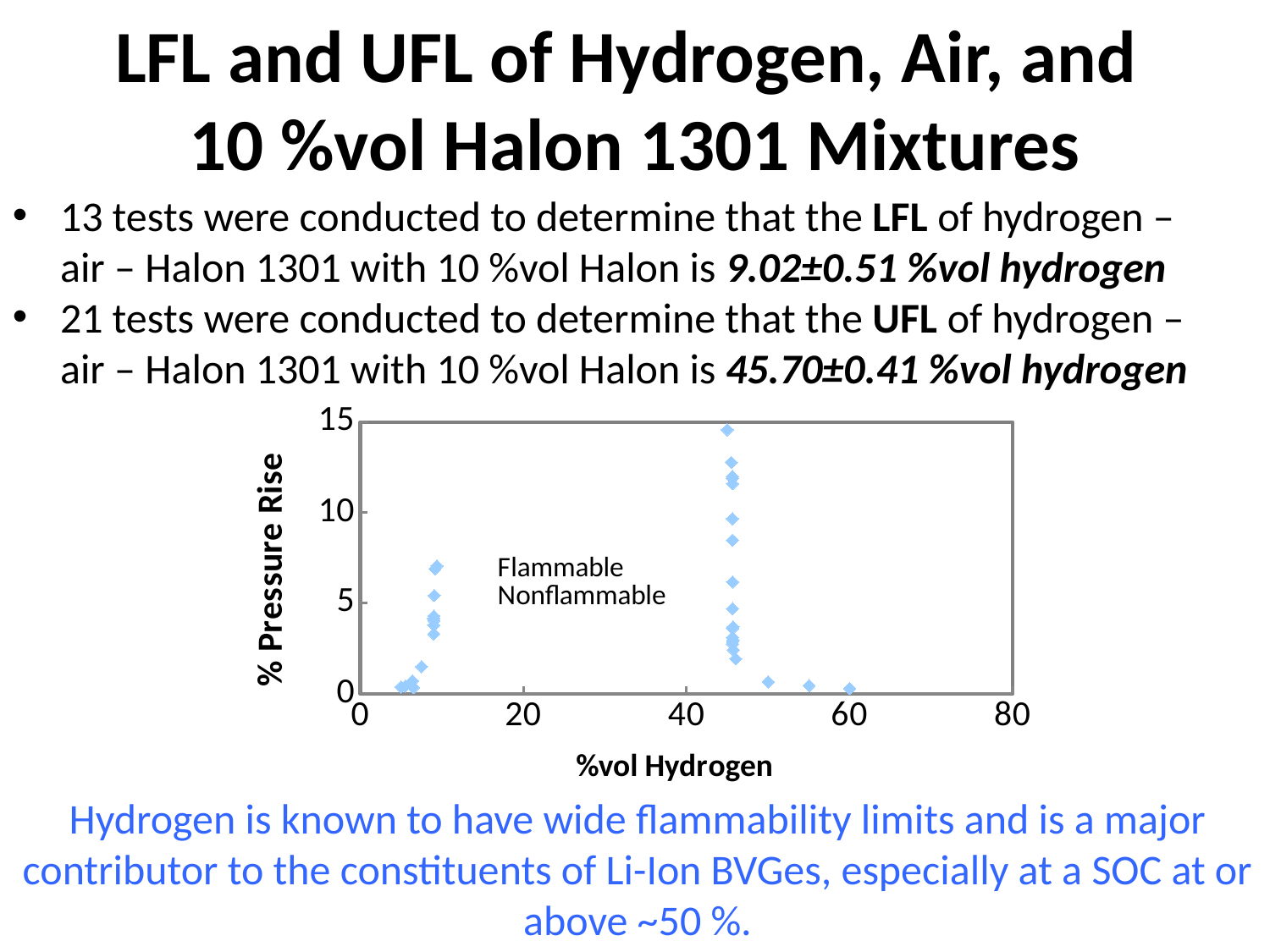
Which cluster of points reaches a higher % Pressure Rise: the one near 10 %vol Hydrogen or the one near 45 %vol Hydrogen? the one near 45 %vol Hydrogen Is the % Pressure Rise for the point at 50 %vol Hydrogen greater or less than 5? less What is the title of the chart's y axis? % Pressure Rise Is the highest % Pressure Rise value plotted on the chart greater or less than 10? greater Is the highest % Pressure Rise plotted near 45 %vol Hydrogen greater or less than 5? greater What is the title of the chart's x axis? %vol Hydrogen What kind of chart is shown on the slide? scatter chart Around which %vol Hydrogen value does the point with the highest % Pressure Rise occur: near 10, near 45, or near 60? near 45